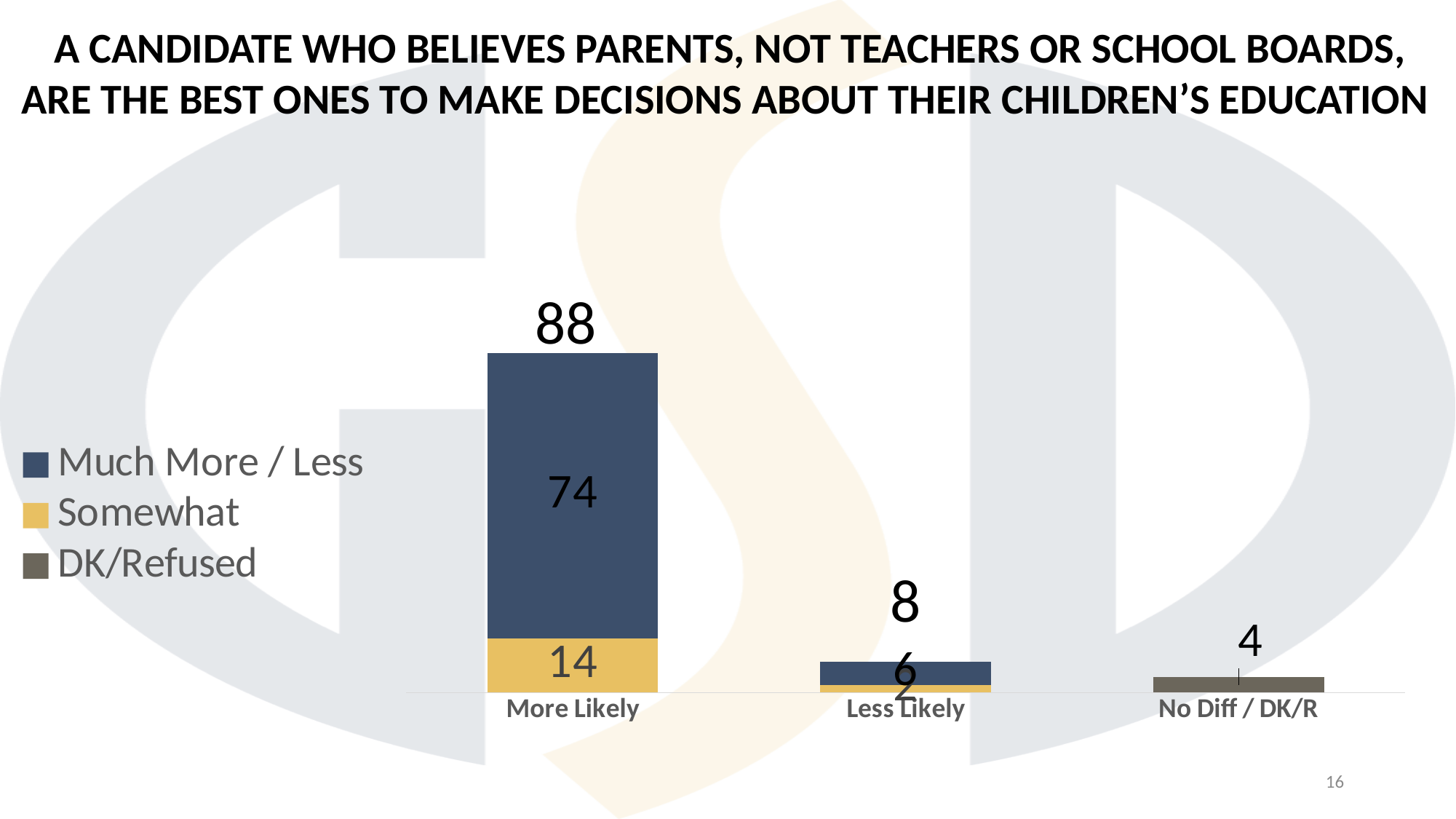
What is the Much More / Less value for Less Likely? 6 How many series does the legend list? 3 What kind of chart is shown on the slide? Stacked bar chart What is the Somewhat value for More Likely? 14 What is the value for No Diff / DK/R? 4 What is the Much More / Less value for More Likely? 74 What is the total value shown above the Less Likely bar? 8 What is the difference between the Much More / Less values for More Likely and Less Likely? 68 What is the total value shown above the More Likely bar? 88 Which is larger, the Less Likely total or the No Diff / DK/R value? Less Likely total What is the Somewhat value for Less Likely? 2 Which category has the highest total? More Likely